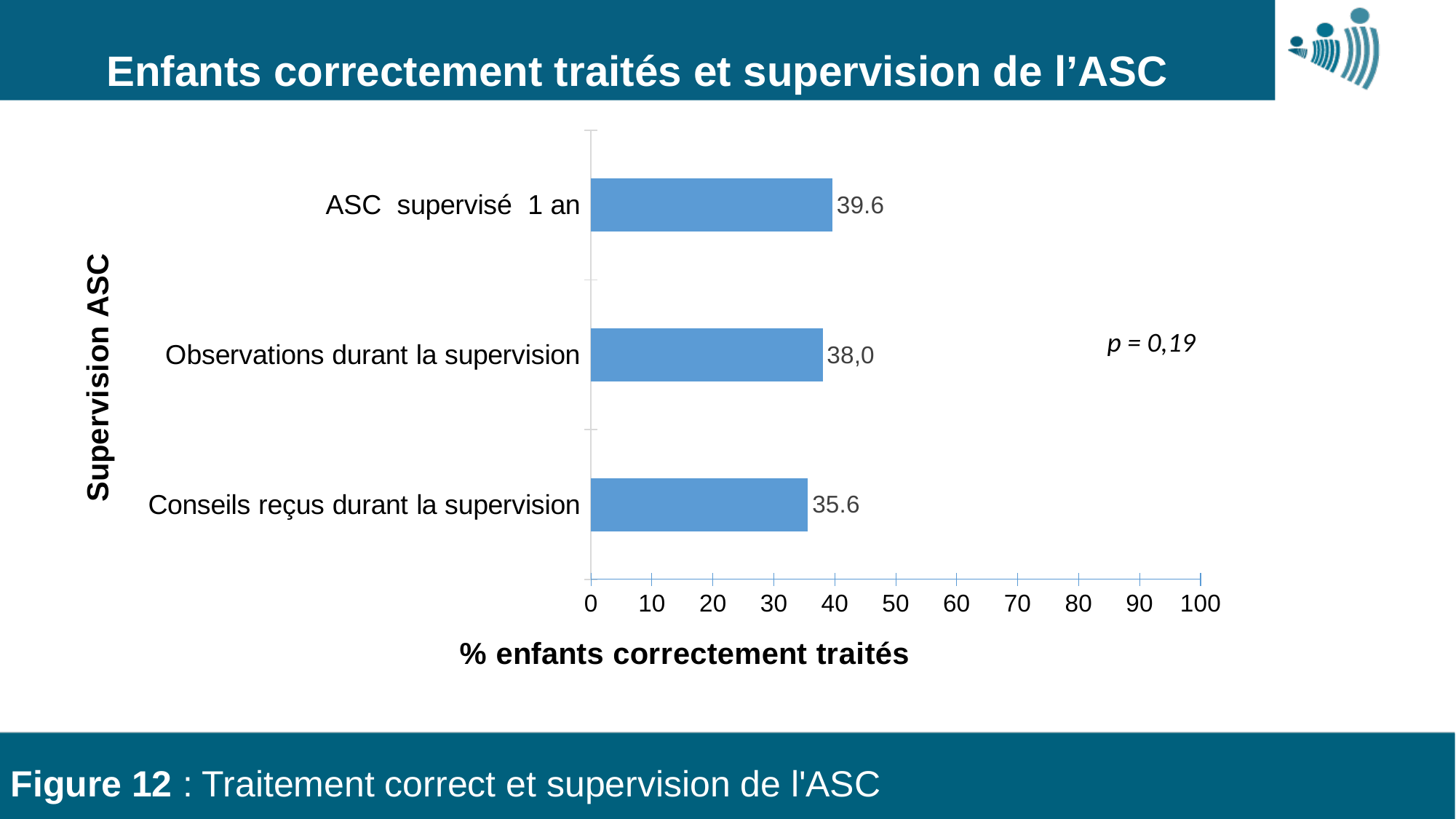
What is the value for "Conseils reçus durant la supervision"? 35.6 Which category has the lowest percentage of children correctly treated? Conseils reçus durant la supervision What is the difference between the values for "Observations durant la supervision" and "Conseils reçus durant la supervision"? 2.4 What is the value for "ASC supervisé 1 an"? 39.6 What is the label of the x axis? % enfants correctement traités Is the value for "Conseils reçus durant la supervision" greater or less than 50? less What is the value for "Observations durant la supervision"? 38,0 What kind of chart is shown on the slide? bar chart Which is larger: the value for "ASC supervisé 1 an" or the value for "Observations durant la supervision"? ASC supervisé 1 an How many categories are shown in the chart? 3 What is the difference between the values for "ASC supervisé 1 an" and "Conseils reçus durant la supervision"? 4.0 Which category has the highest percentage of children correctly treated? ASC supervisé 1 an